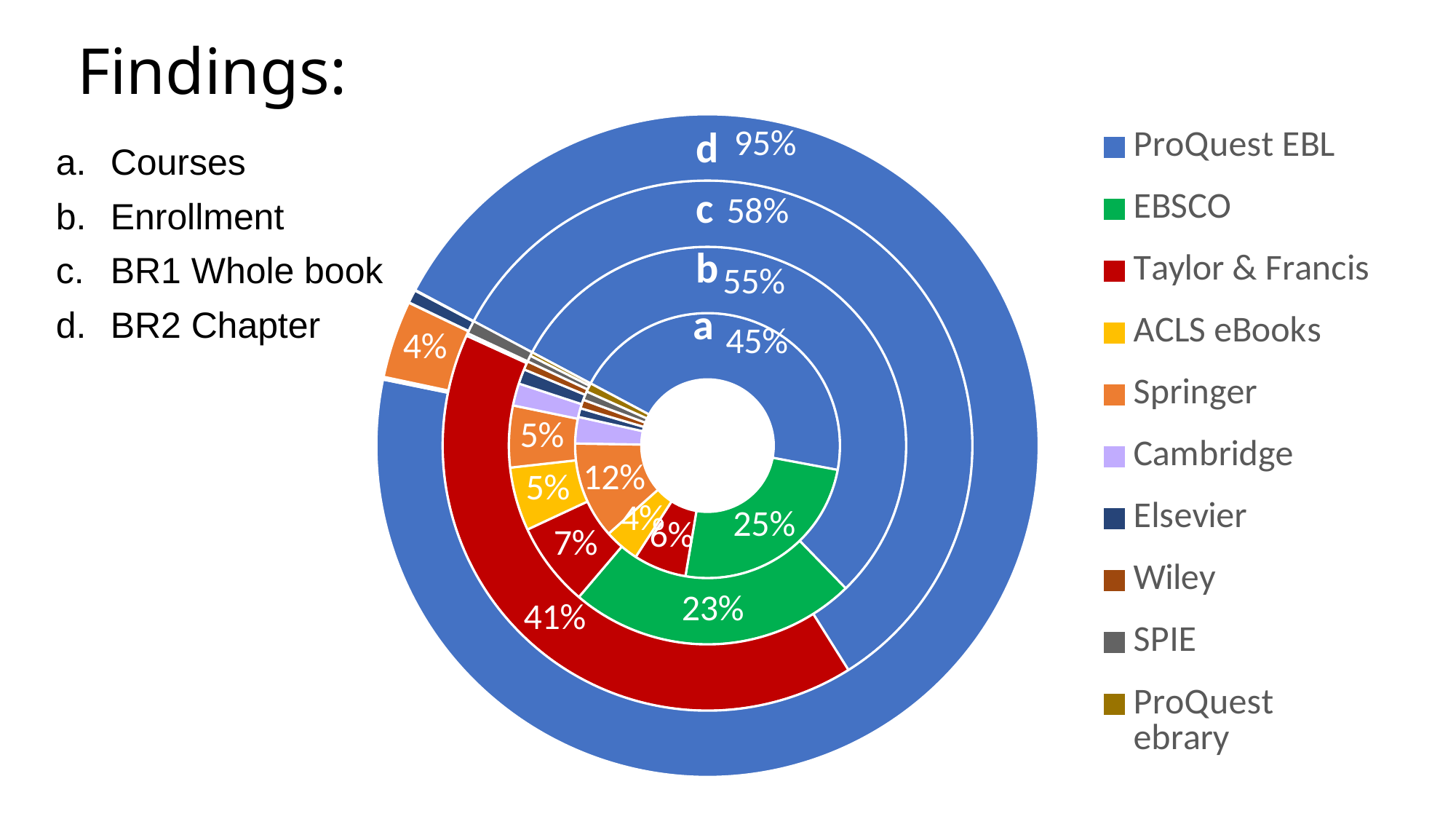
In ring b (Enrollment), which is larger: the EBSCO share or the Taylor & Francis share? EBSCO Which ring label corresponds to Enrollment according to the list on the slide? b What is the EBSCO share in ring a (Courses)? 25% How many entries does the legend list? 10 What type of chart is shown on the slide? doughnut chart What is the difference between the ProQuest EBL share in ring d (95%) and in ring c (58%)? 37% What is the ProQuest EBL share in ring c (BR1 Whole book)? 58% What is the ProQuest EBL share in ring b (Enrollment)? 55% What is the ProQuest EBL share in ring d (BR2 Chapter)? 95% Which publisher has the largest share in ring d (BR2 Chapter)? ProQuest EBL What is the Springer share in ring a (Courses)? 12% What is the Taylor & Francis share in ring c (BR1 Whole book)? 41%